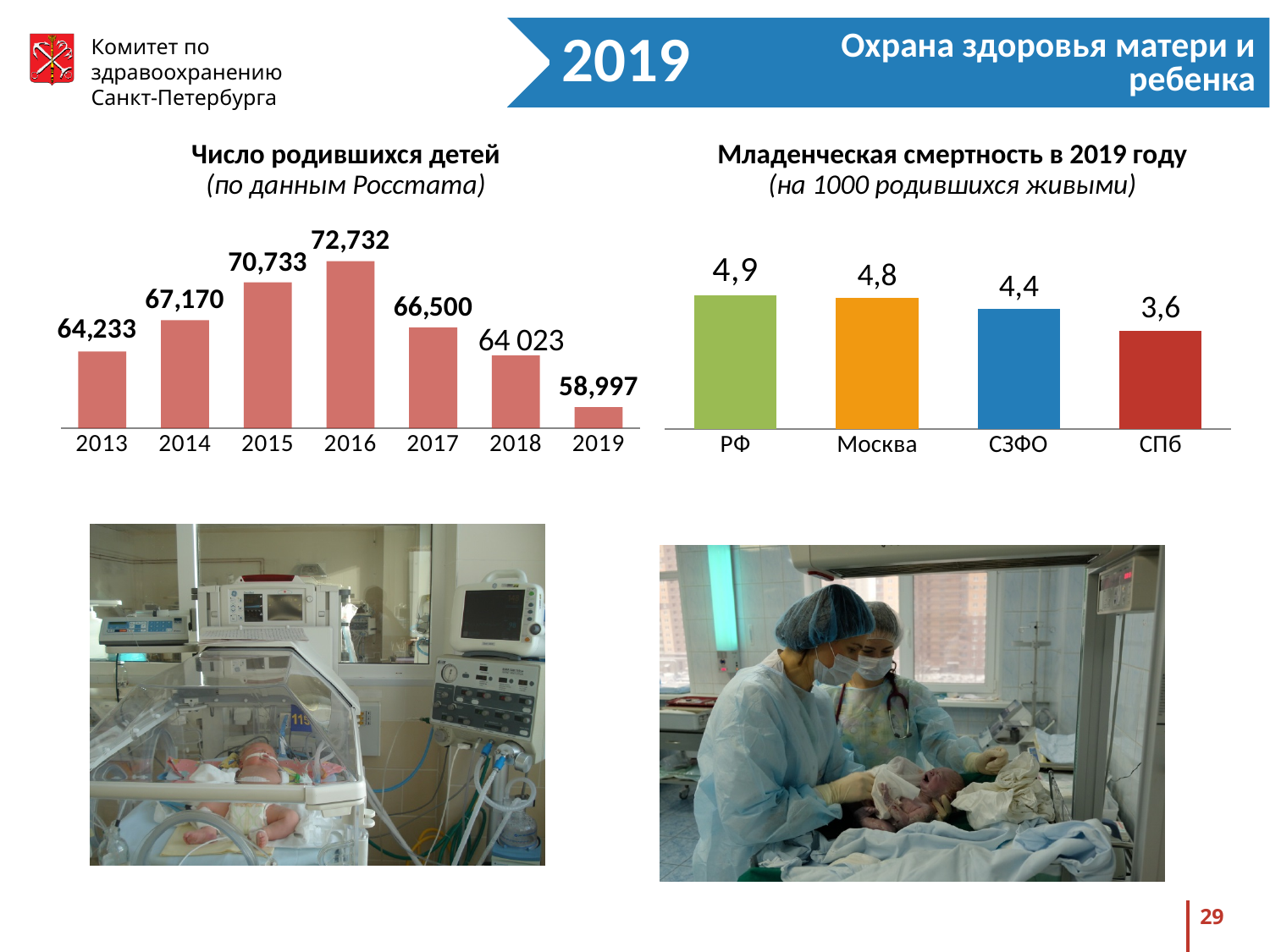
In the chart 'Младенческая смертность в 2019 году', which is larger, the value for СЗФО or the value for СПб? СЗФО In the chart 'Младенческая смертность в 2019 году', which category has the lowest value? СПб In the chart 'Число родившихся детей', which year has the highest value? 2016 In the chart 'Число родившихся детей', what is the difference between the values for 2016 and 2019? 13,735 In the chart 'Число родившихся детей', which year has the lowest value? 2019 In the chart 'Младенческая смертность в 2019 году', what is the value for Москва? 4,8 In the chart 'Число родившихся детей', what is the value for 2019? 58,997 In the chart 'Число родившихся детей', do the values rise or fall from 2016 to 2019? fall What kind of chart is 'Младенческая смертность в 2019 году'? bar chart In the chart 'Младенческая смертность в 2019 году', what is the difference between the values for РФ and СПб? 1,3 In the chart 'Число родившихся детей', how many years are shown on the x axis? 7 In the chart 'Число родившихся детей', what is the value for 2016? 72,732